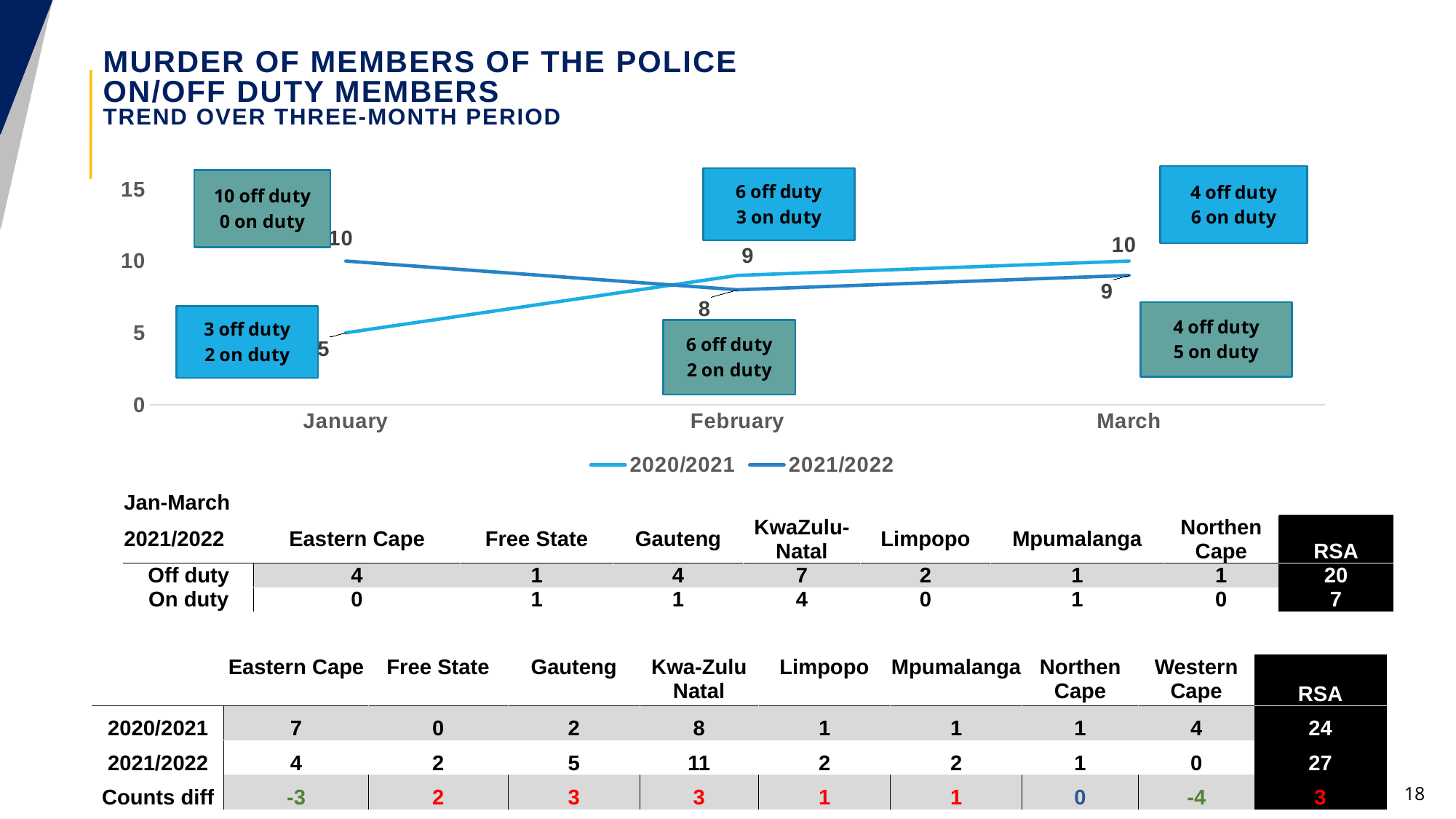
What type of chart is shown on the slide? line chart What is the value for 2021/2022 in January? 10 How many months are plotted on the x axis of the chart? 3 What is the value for 2020/2021 in February? 9 What is the value for 2020/2021 in January? 5 How many series does the chart legend list? 2 What is the value for 2021/2022 in March? 9 In which month is the 2021/2022 series lowest? February What is the difference between the 2021/2022 and 2020/2021 values in January? 5 In which month is the 2020/2021 series highest? March Does the 2020/2021 series rise or fall from January to March? rise Which series has the larger value in February, 2020/2021 or 2021/2022? 2020/2021